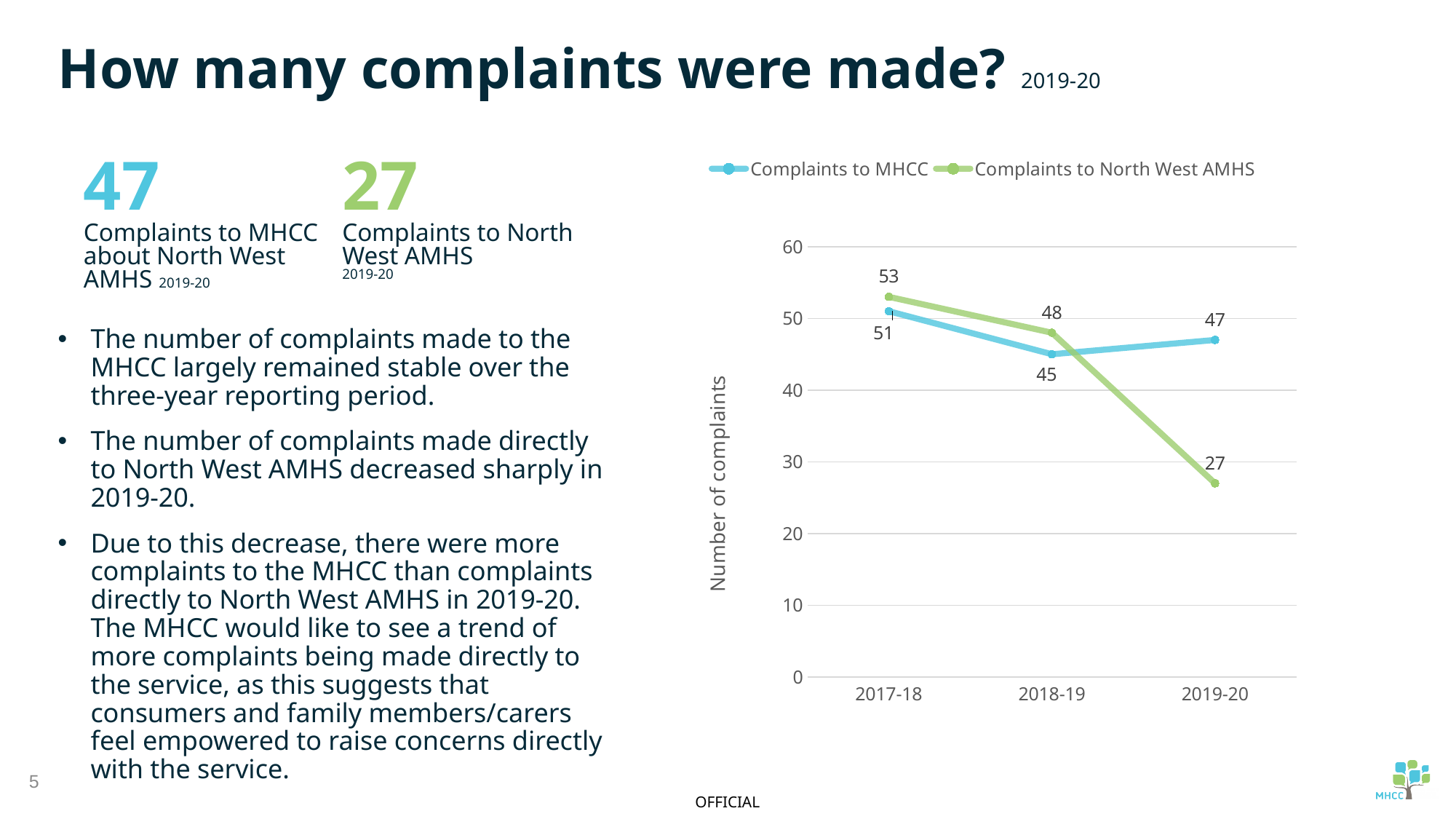
In which year is the value for Complaints to MHCC lowest? 2018-19 What is the label of the y axis? Number of complaints What is the difference between Complaints to MHCC and Complaints to North West AMHS in 2019-20? 20 How many years are plotted on the x axis? 3 What kind of chart is shown on the slide? line chart What is the value for Complaints to MHCC in 2017-18? 51 Which series has the larger value in 2018-19, Complaints to MHCC or Complaints to North West AMHS? Complaints to North West AMHS How many series does the legend list? 2 What is the value for Complaints to MHCC in 2018-19? 45 What is the value for Complaints to North West AMHS in 2019-20? 27 Do the values for Complaints to North West AMHS rise or fall from 2017-18 to 2019-20? fall In which year is the value for Complaints to North West AMHS highest? 2017-18